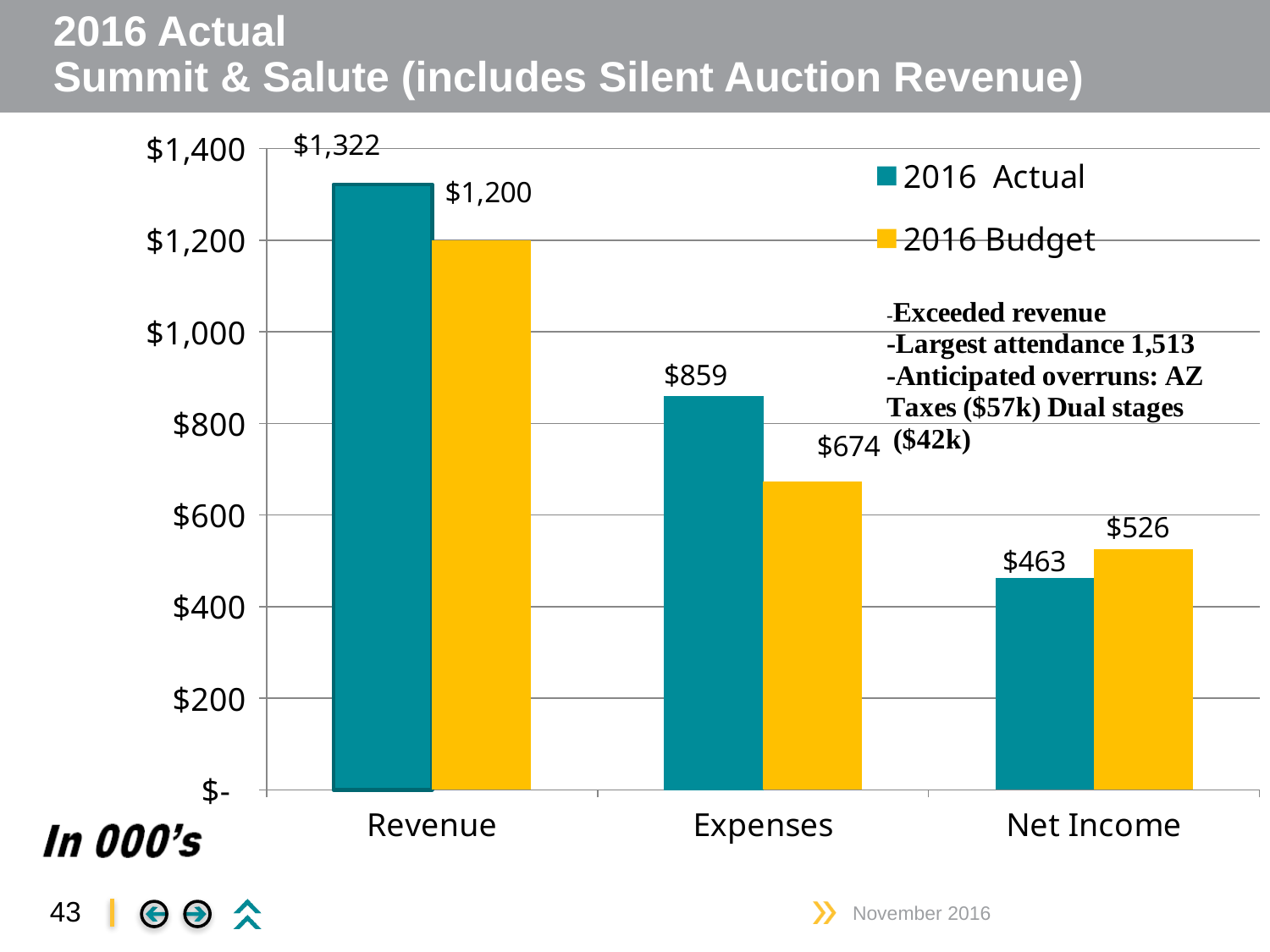
What kind of chart is shown on the slide? Bar chart How many series does the legend list? 2 How many categories are shown on the x axis? 3 What is the 2016 Budget value for Expenses? $674 For Net Income, which is larger: 2016 Actual or 2016 Budget? 2016 Budget What is the difference between the 2016 Actual and 2016 Budget values for Revenue? $122 What is the difference between the 2016 Actual and 2016 Budget values for Expenses? $185 Which category has the highest 2016 Actual value? Revenue Which category has the lowest 2016 Budget value? Net Income What is the 2016 Budget value for Net Income? $526 What is the 2016 Actual value for Revenue? $1,322 What is the 2016 Actual value for Net Income? $463